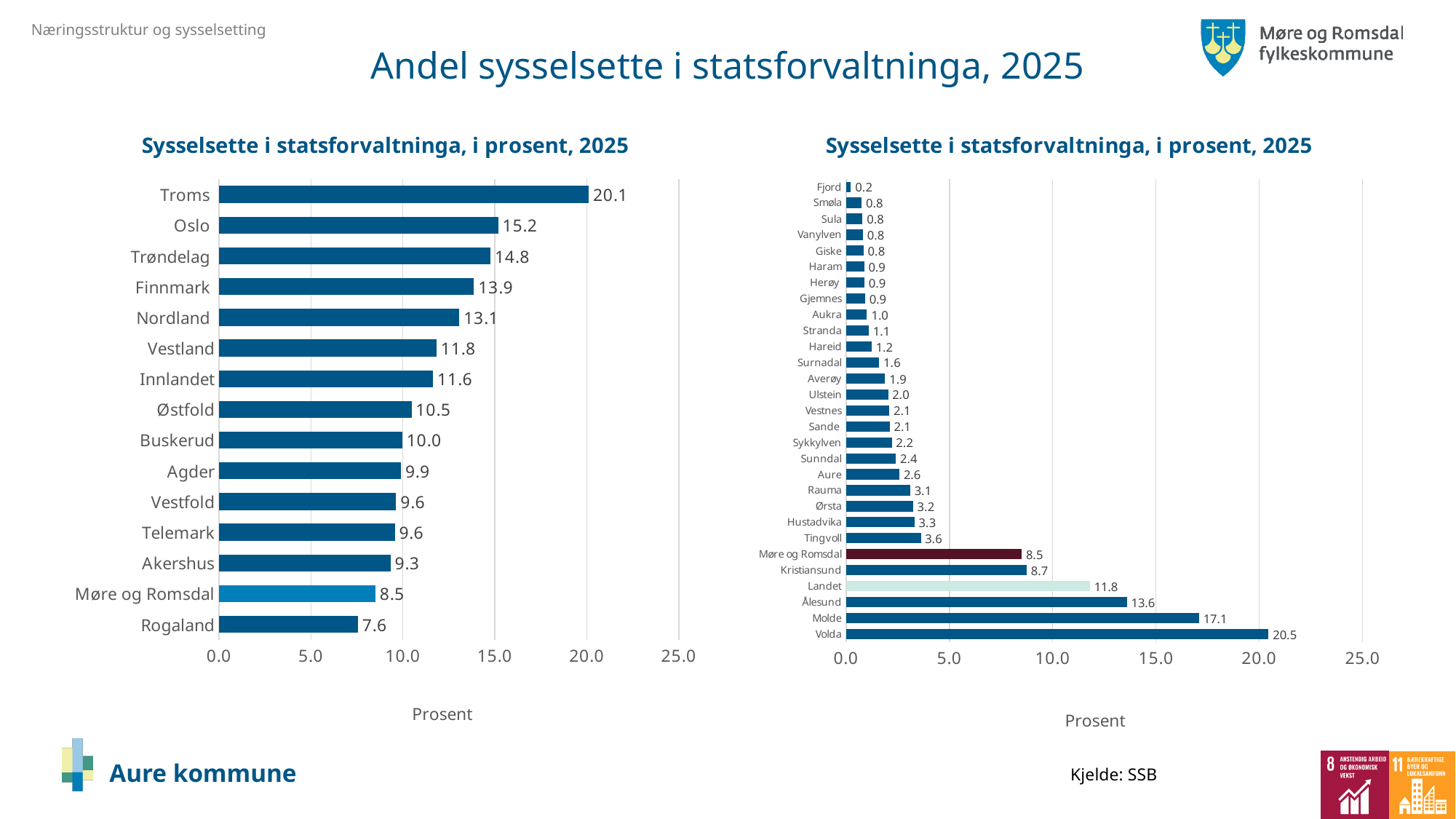
In the left chart, what is the value for Troms? 20.1 In the left chart, what is the difference between Oslo and Trøndelag? 0.4 In the right chart, which category has the highest value? Volda In the left chart, which category has the lowest value? Rogaland In the left chart, how many categories are shown? 15 In the right chart, how many categories are shown? 29 In the right chart, what is the value for Aure? 2.6 In the right chart, which category has the lowest value? Fjord In the right chart, what is the difference between Volda and Molde? 3.4 What kind of chart is the left chart? Bar chart In the right chart, which is larger, Molde or Ålesund? Molde In the left chart, what is the value for Møre og Romsdal? 8.5